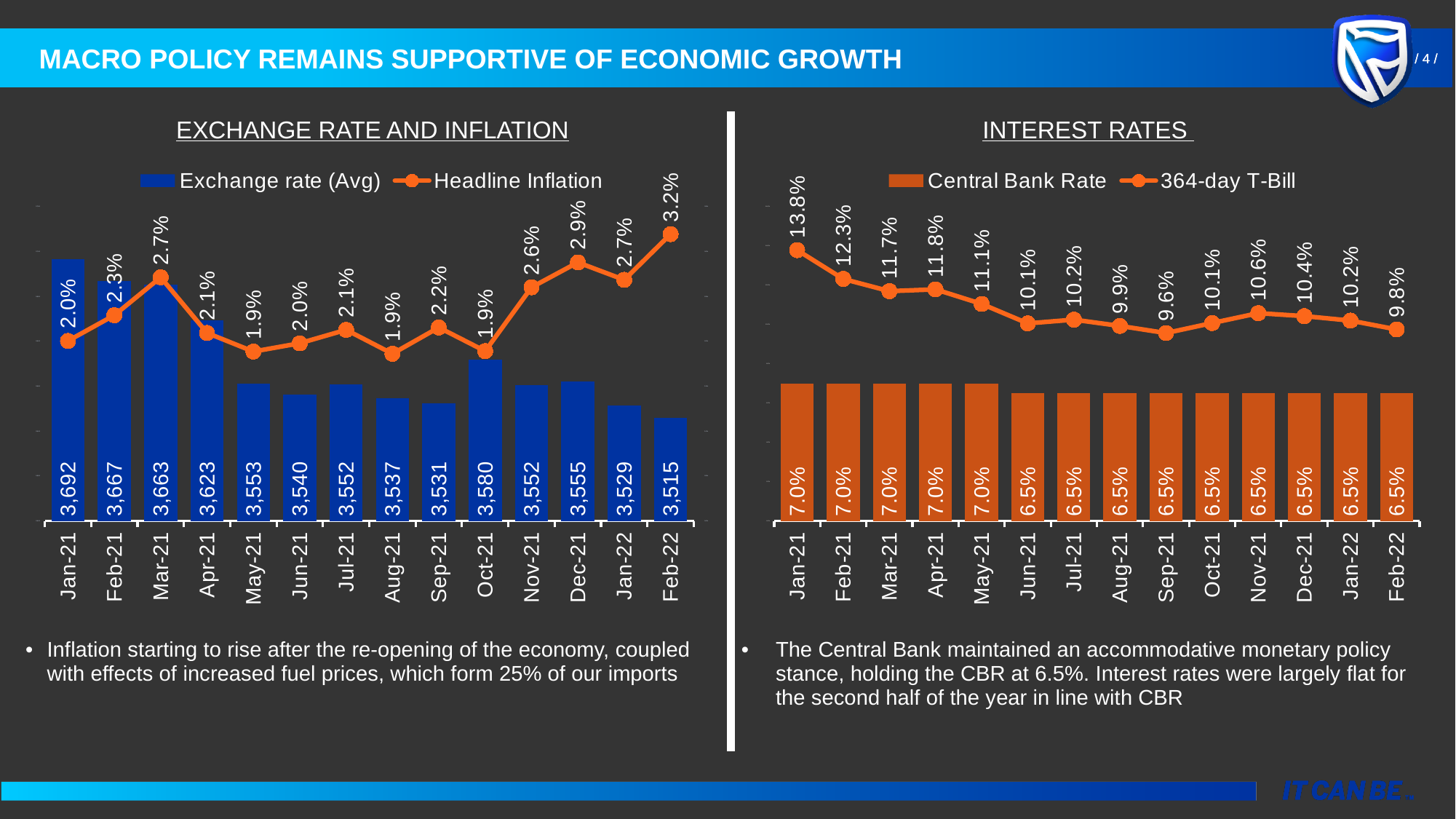
In the Interest Rates chart, is the 364-day T-Bill rate higher in Nov-21 or Sep-21? Nov-21 In the Interest Rates chart, which month has the lowest 364-day T-Bill rate? Sep-21 In the Interest Rates chart, how many series does the legend list? 2 In the Exchange Rate and Inflation chart, which month has the lowest exchange rate (Avg)? Feb-22 In the Exchange Rate and Inflation chart, what is the exchange rate (Avg) for Jan-21? 3,692 In the Exchange Rate and Inflation chart, what is the headline inflation for Feb-22? 3.2% In the Interest Rates chart, what is the 364-day T-Bill rate for Jan-21? 13.8% In the Interest Rates chart, does the 364-day T-Bill rate generally rise or fall from Jan-21 to Feb-22? fall In the Exchange Rate and Inflation chart, what is the difference between the exchange rate in Jan-21 and Feb-22? 177 In the Exchange Rate and Inflation chart, how many months are shown on the x axis? 14 In the Interest Rates chart, what is the Central Bank Rate for Feb-22? 6.5% In the Exchange Rate and Inflation chart, which month has the highest headline inflation? Feb-22